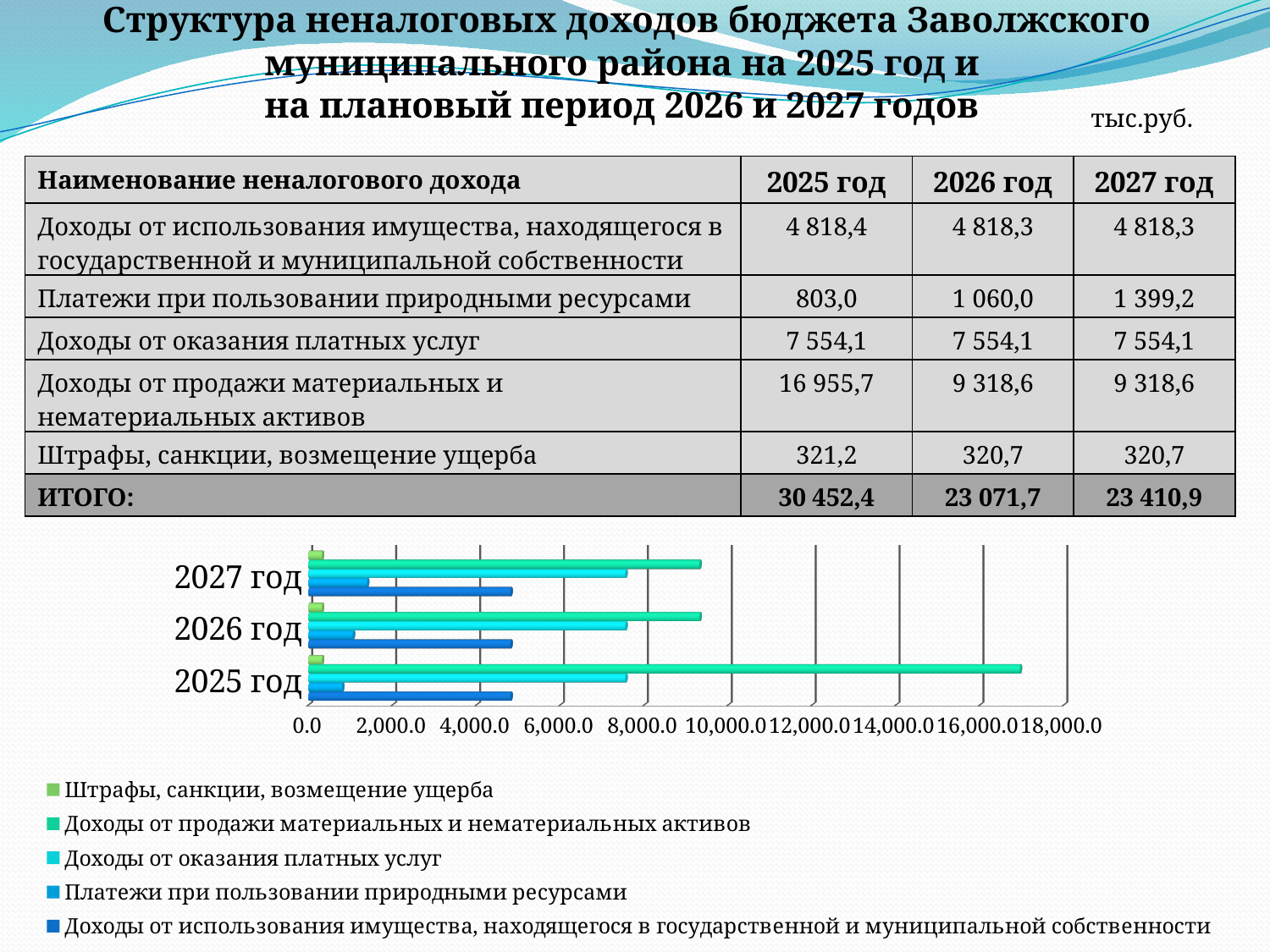
In the bar chart, is the value for "Платежи при пользовании природными ресурсами" in 2027 год greater or less than 2,000.0? less What is the ИТОГО value for 2026 год shown on the slide? 23 071,7 Which is larger: "Платежи при пользовании природными ресурсами" in 2026 год or in 2027 год? 2027 год How many year categories does the bar chart show? 3 What kind of chart is shown below the table on the slide? bar chart Does the value of "Платежи при пользовании природными ресурсами" rise or fall from 2025 год to 2027 год? rise How many series does the legend of the bar chart list? 5 In the bar chart, is the value for "Доходы от продажи материальных и нематериальных активов" in 2025 год greater or less than 16,000.0? greater According to the slide, what is the value of "Доходы от оказания платных услуг" for 2025 год? 7 554,1 Which series is shown in light green in the bar chart legend? Штрафы, санкции, возмещение ущерба In which year is the bar for "Доходы от продажи материальных и нематериальных активов" the longest? 2025 год What is the difference between the ИТОГО values for 2027 год and 2026 год? 339,2